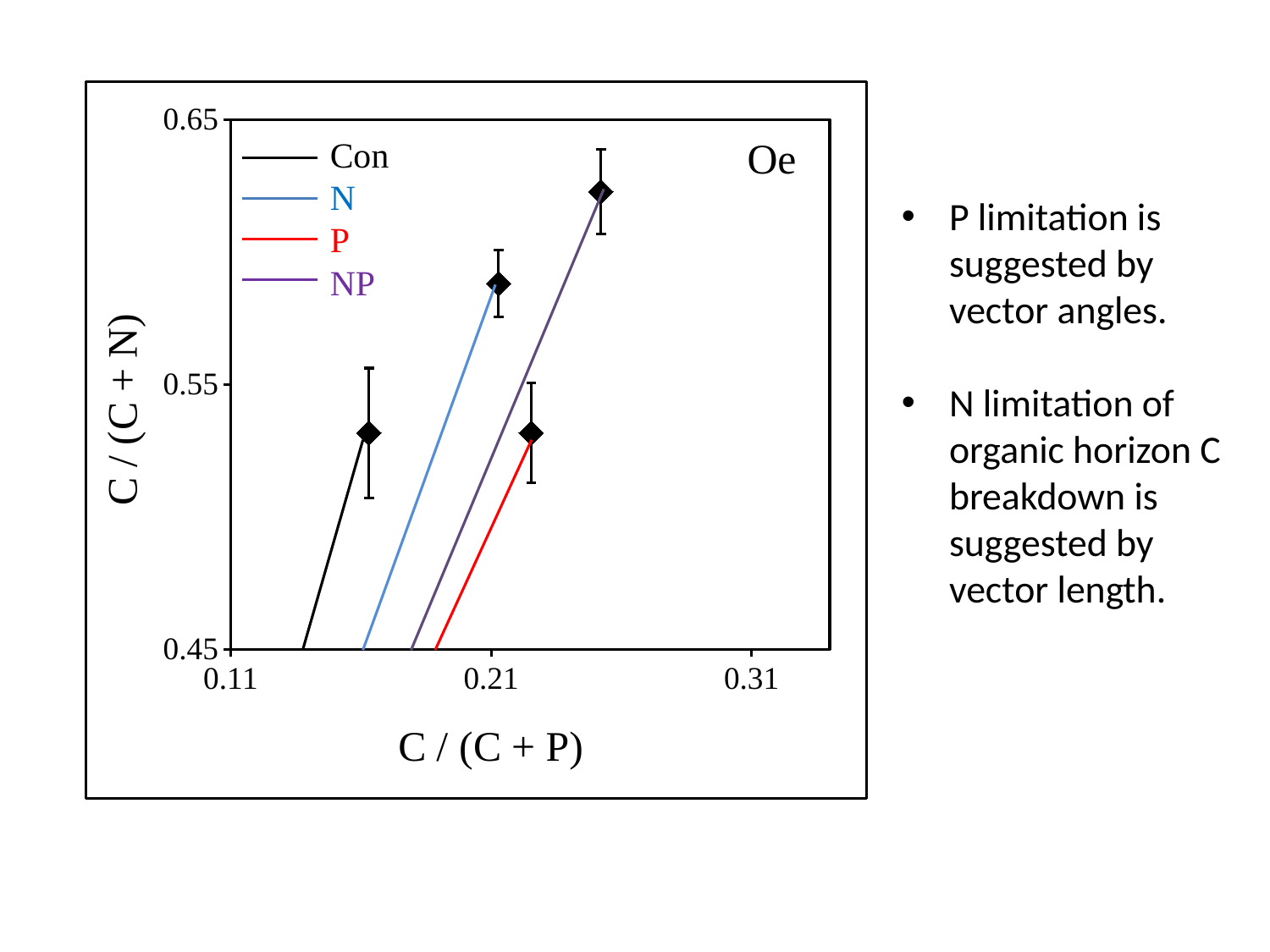
Is the C / (C + N) value at the end point of the Con vector greater or less than 0.55? less Is the C / (C + N) value at the end point of the N vector greater or less than 0.55? greater How many diamond end points are plotted on the chart? 4 Is the C / (C + N) value at the end point of the NP vector greater or less than 0.55? greater How many series does the legend list? 4 Which end point has the larger C / (C + N) value, N or P? N What is the label of the x axis? C / (C + P) Which end point has the larger C / (C + P) value, NP or Con? NP What are the series names listed in the legend? Con, N, P, NP Which series has the highest C / (C + N) value at its end point? NP